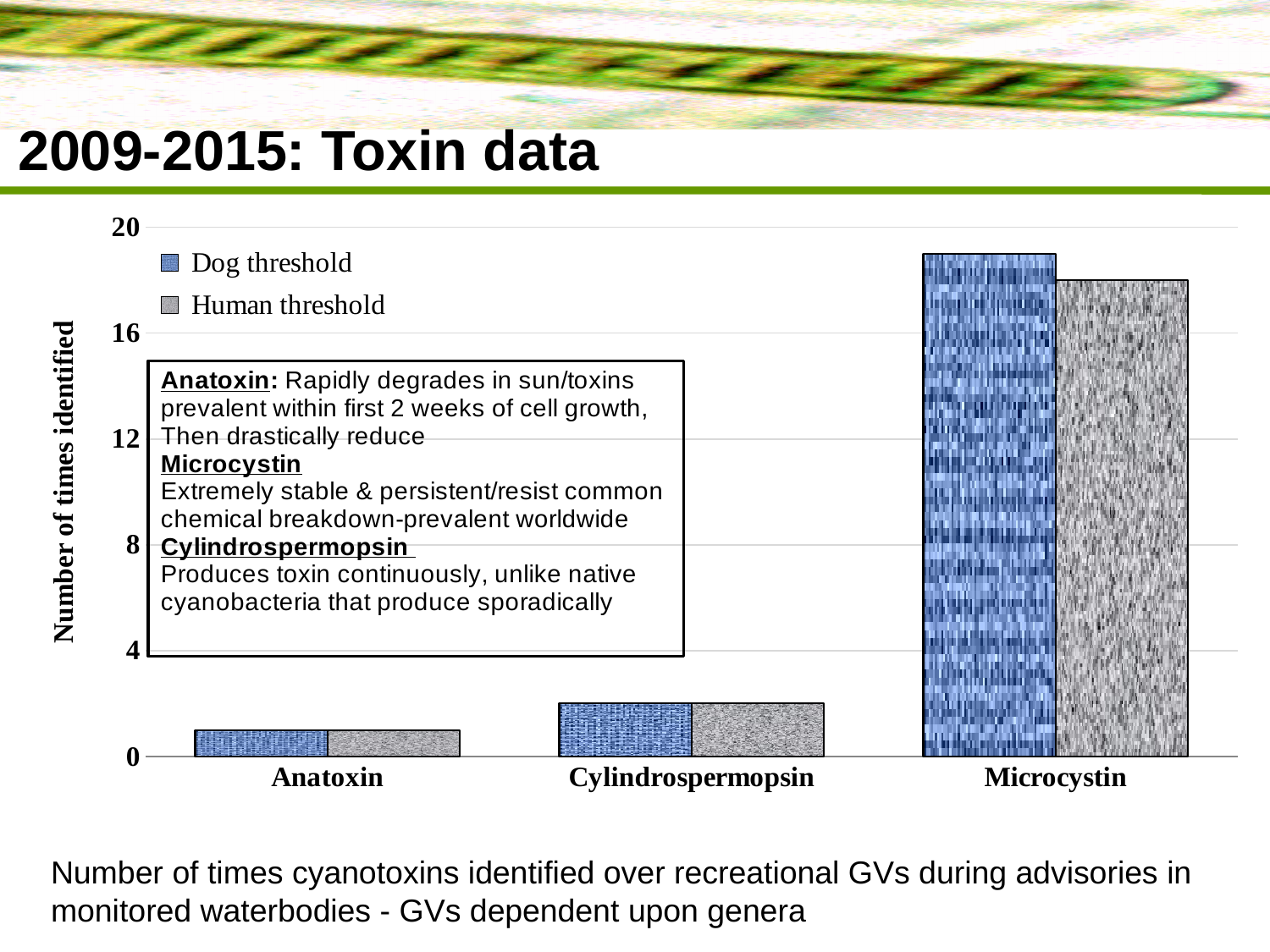
Is the Dog threshold value for Microcystin greater or less than 16? greater Is the Dog threshold value for Anatoxin greater or less than 4? less Which series in the legend is shown in blue? Dog threshold What kind of chart is shown on the slide? bar chart Which is larger: the Dog threshold value for Microcystin or the Dog threshold value for Cylindrospermopsin? Microcystin Is the Human threshold value for Cylindrospermopsin greater or less than 4? less What is the title of the chart's vertical axis? Number of times identified Which toxin has the lowest number of times identified for the Human threshold series? Anatoxin Which toxin has the highest number of times identified for the Dog threshold series? Microcystin How many toxin categories are shown on the x axis of the chart? 3 How many series does the chart's legend list? 2